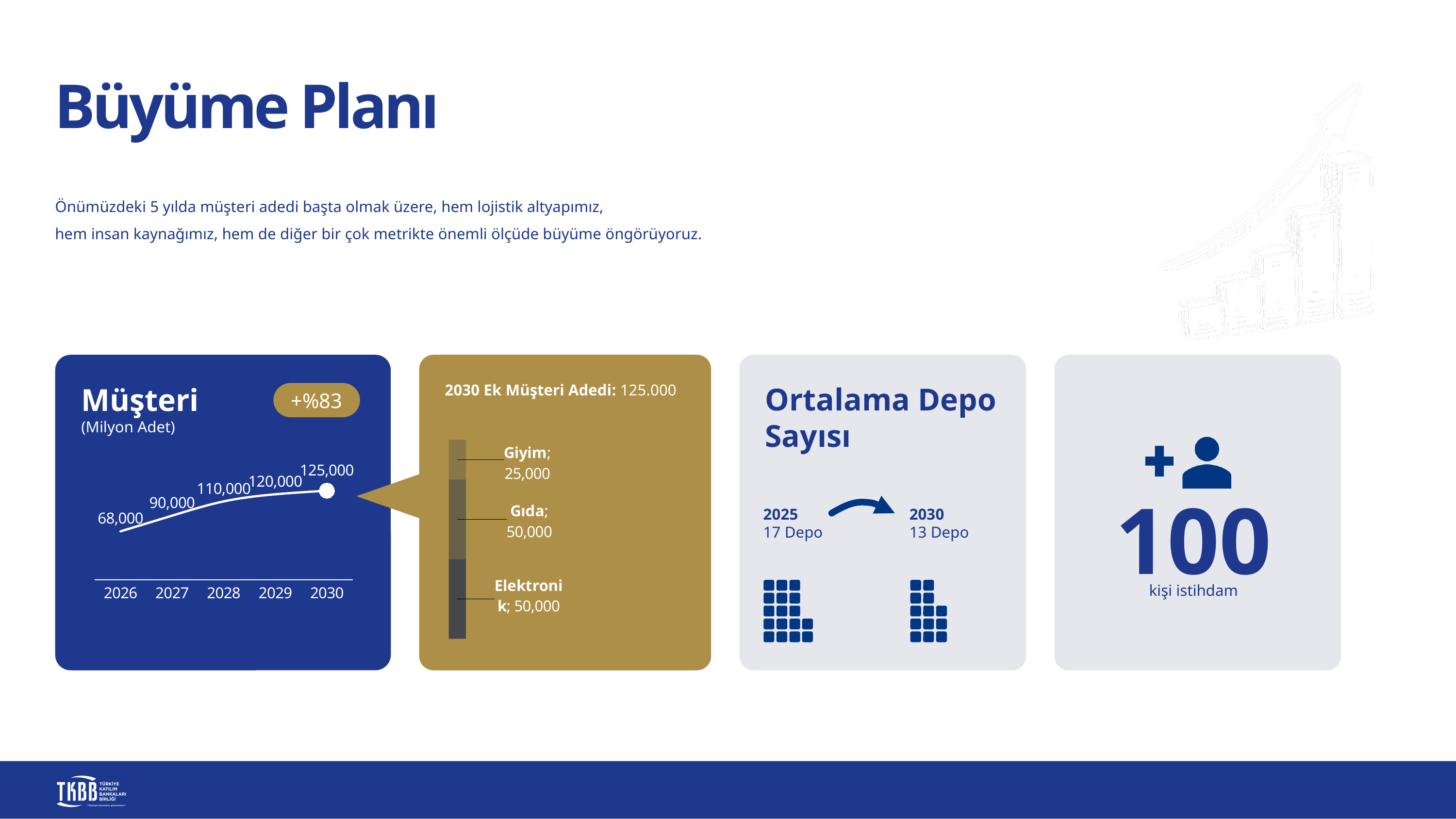
In the Müşteri (Milyon Adet) chart, which year has the highest value? 2030 What kind of chart is the Müşteri (Milyon Adet) chart? line chart In the Müşteri (Milyon Adet) chart, which year has the lowest value? 2026 In the 2030 Ek Müşteri Adedi stacked bar chart, which segment is the smallest? Giyim In the Müşteri (Milyon Adet) chart, what is the value for 2026? 68,000 In the Müşteri (Milyon Adet) chart, do the values rise or fall from 2026 to 2030? rise In the 2030 Ek Müşteri Adedi stacked bar chart, what is the value for Gıda? 50,000 In the Müşteri (Milyon Adet) chart, what is the difference between the 2027 and 2026 values? 22,000 How many years are plotted in the Müşteri (Milyon Adet) chart? 5 In the Müşteri (Milyon Adet) chart, what is the value for 2030? 125,000 In the Müşteri (Milyon Adet) chart, what is the value for 2028? 110,000 In the 2030 Ek Müşteri Adedi stacked bar chart, what is the total of the three segments? 125,000